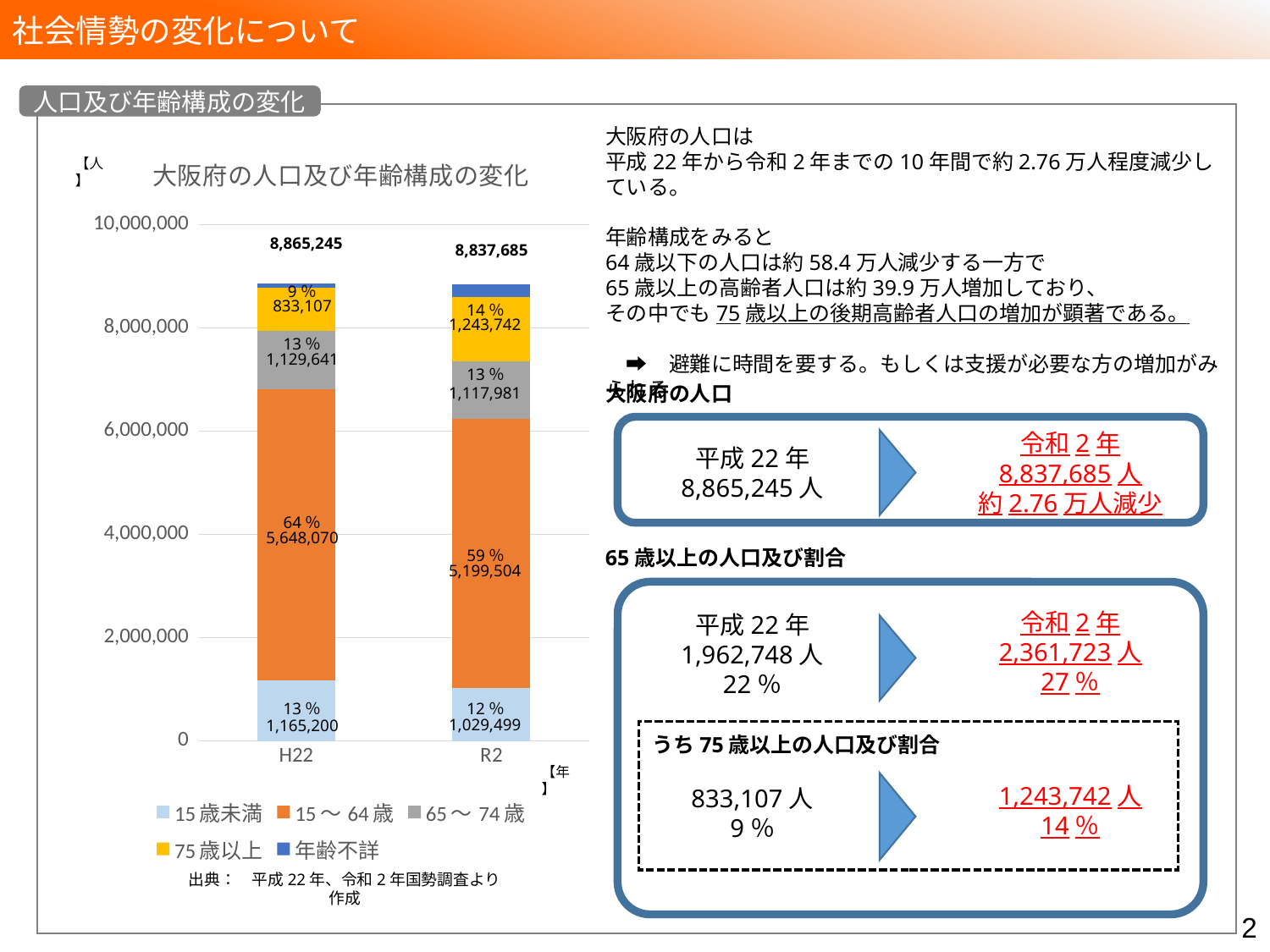
What is the value of the 15～64歳 segment for H22? 5,648,070 How many categories are shown on the x axis of the chart? 2 What is the value of the 75歳以上 segment for R2? 1,243,742 What is the title of the chart? 大阪府の人口及び年齢構成の変化 Does the total population rise or fall from H22 to R2? Fall How many series does the chart legend list? 5 Which category has the larger 15～64歳 value, H22 or R2? H22 What is the total population shown above the R2 bar? 8,837,685 What is the difference between the 75歳以上 values for R2 and H22? 410,635 What is the total population shown above the H22 bar? 8,865,245 What percentage does the 15歳未満 segment represent for R2? 12 % What type of chart is shown on the slide? Stacked bar chart